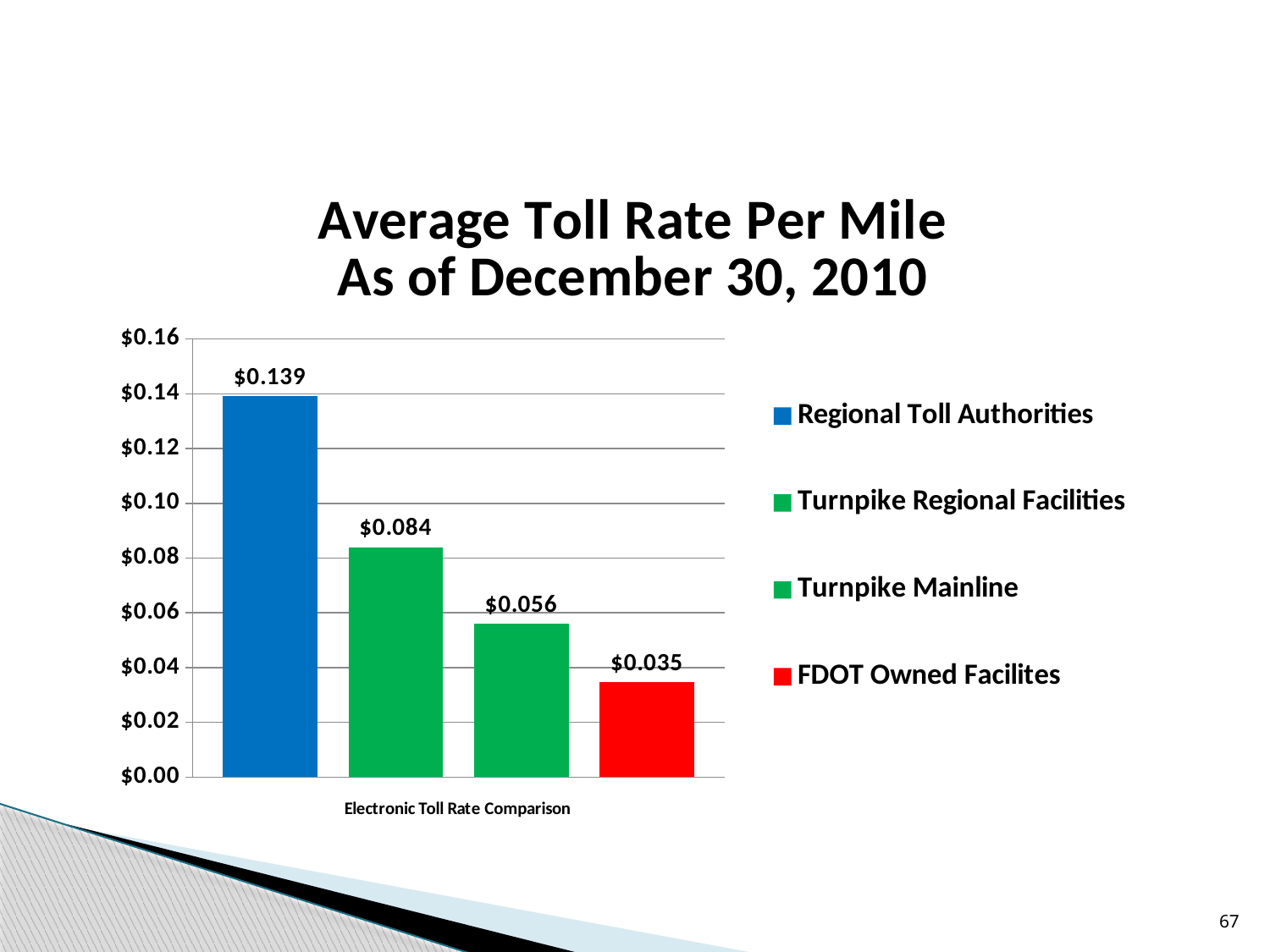
What kind of chart is shown on the slide? Bar chart Which is larger, the toll rate for Turnpike Mainline or for FDOT Owned Facilites? Turnpike Mainline What is the difference between the toll rate for Turnpike Regional Facilities and Turnpike Mainline? $0.028 What is the difference between the toll rate for Regional Toll Authorities and FDOT Owned Facilites? $0.104 What is the title of the chart? Average Toll Rate Per Mile As of December 30, 2010 What is the average toll rate per mile for FDOT Owned Facilites? $0.035 Which series has the lowest average toll rate per mile? FDOT Owned Facilites Which series has the highest average toll rate per mile? Regional Toll Authorities How many series does the legend list? 4 What is the average toll rate per mile for Regional Toll Authorities? $0.139 What is the average toll rate per mile for Turnpike Mainline? $0.056 What is the average toll rate per mile for Turnpike Regional Facilities? $0.084